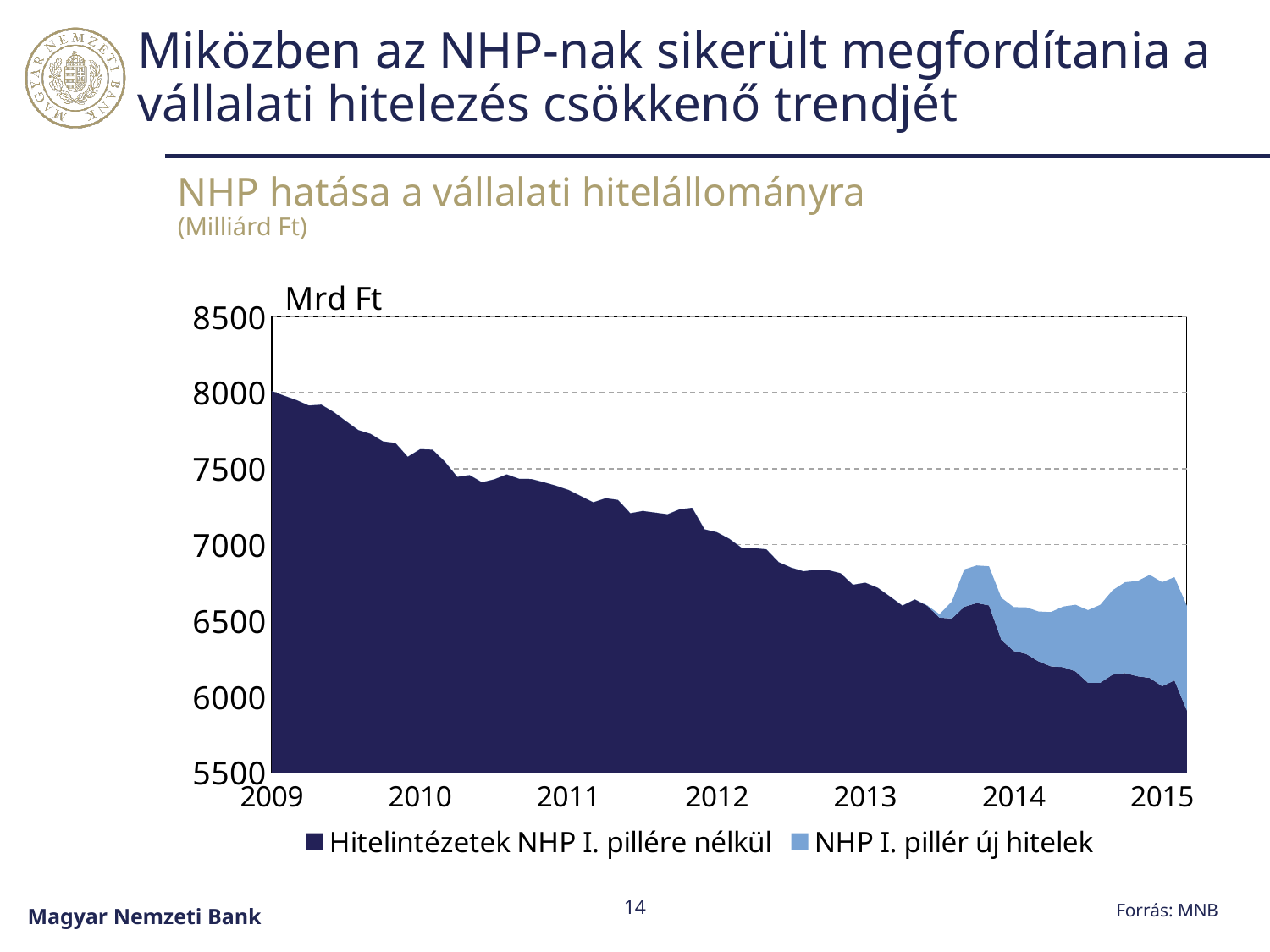
Is the value of 'Hitelintézetek NHP I. pillére nélkül' at 2010 greater or less than 7500? greater How many year labels are shown on the x axis? 7 Is the value of 'Hitelintézetek NHP I. pillére nélkül' at 2015 greater or less than 6500? less Is the value of 'Hitelintézetek NHP I. pillére nélkül' at 2013 greater or less than 7000? less Does the 'Hitelintézetek NHP I. pillére nélkül' series rise or fall from 2009 to 2015? Fall What is the title of the chart? NHP hatása a vállalati hitelállományra Which series is larger at 2015, 'Hitelintézetek NHP I. pillére nélkül' or 'NHP I. pillér új hitelek'? Hitelintézetek NHP I. pillére nélkül What kind of chart is shown on the slide? Area chart How many series does the legend list? 2 What are the two series named in the legend? Hitelintézetek NHP I. pillére nélkül; NHP I. pillér új hitelek